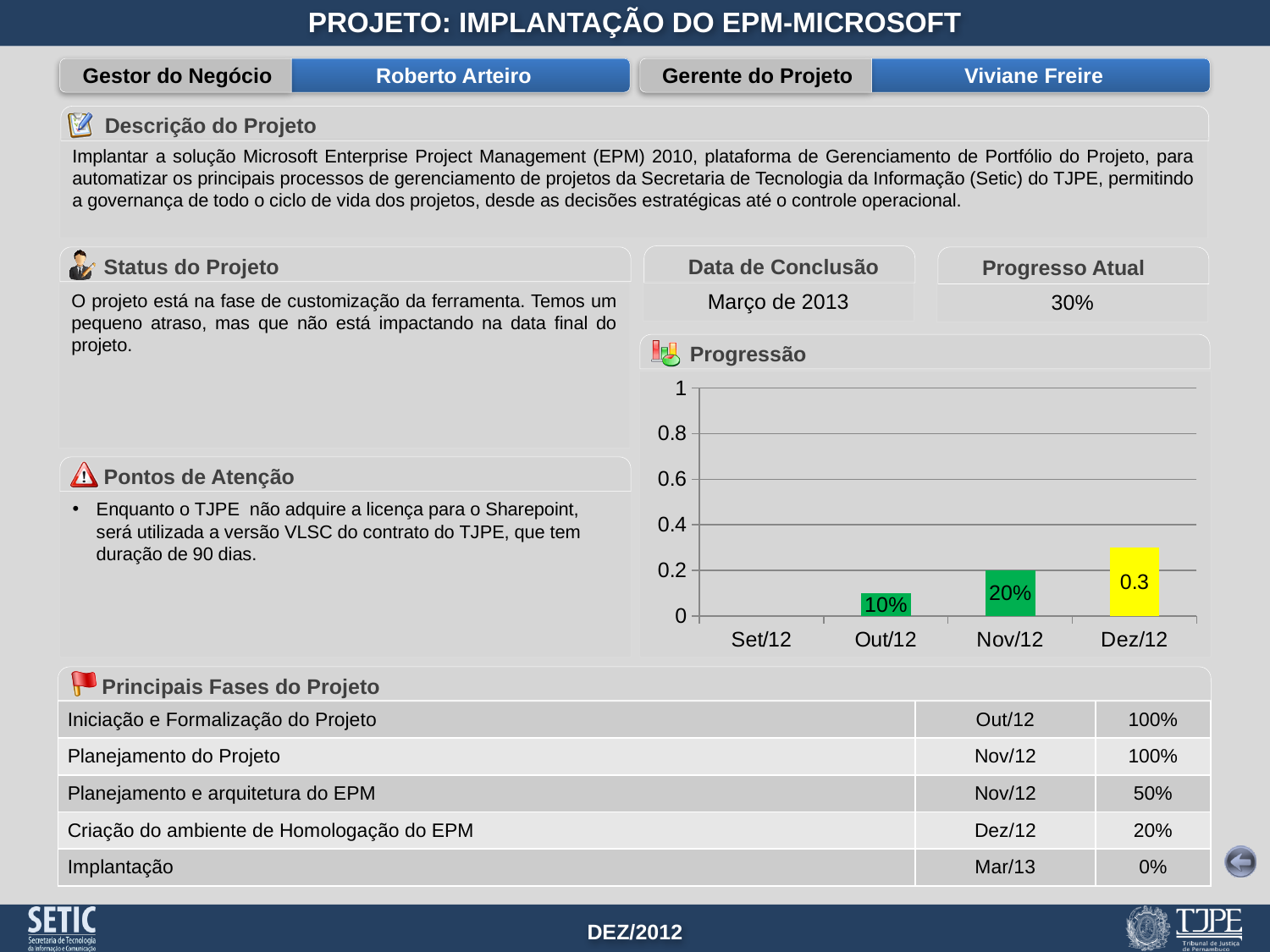
In the Progressão chart, what is the difference between the Nov/12 value and the Out/12 value? 10% What colour is the Dez/12 bar in the Progressão chart? yellow In the Progressão chart, is the value for Dez/12 greater or less than 0.2? greater In the Progressão chart, what is the value for Nov/12? 20% In the Progressão chart, what is the value labelled on the Dez/12 bar? 0.3 In the Progressão chart, what is the value for Out/12? 10% What kind of chart is the Progressão chart? bar chart In the Progressão chart, which is larger, the value for Nov/12 or the value for Out/12? Nov/12 How many months are shown on the x axis of the Progressão chart? 4 In the Progressão chart, which month has the highest bar? Dez/12 In the Progressão chart, is the value for Out/12 greater or less than 0.2? less In the Progressão chart, do the bar values rise or fall from Out/12 to Dez/12? rise